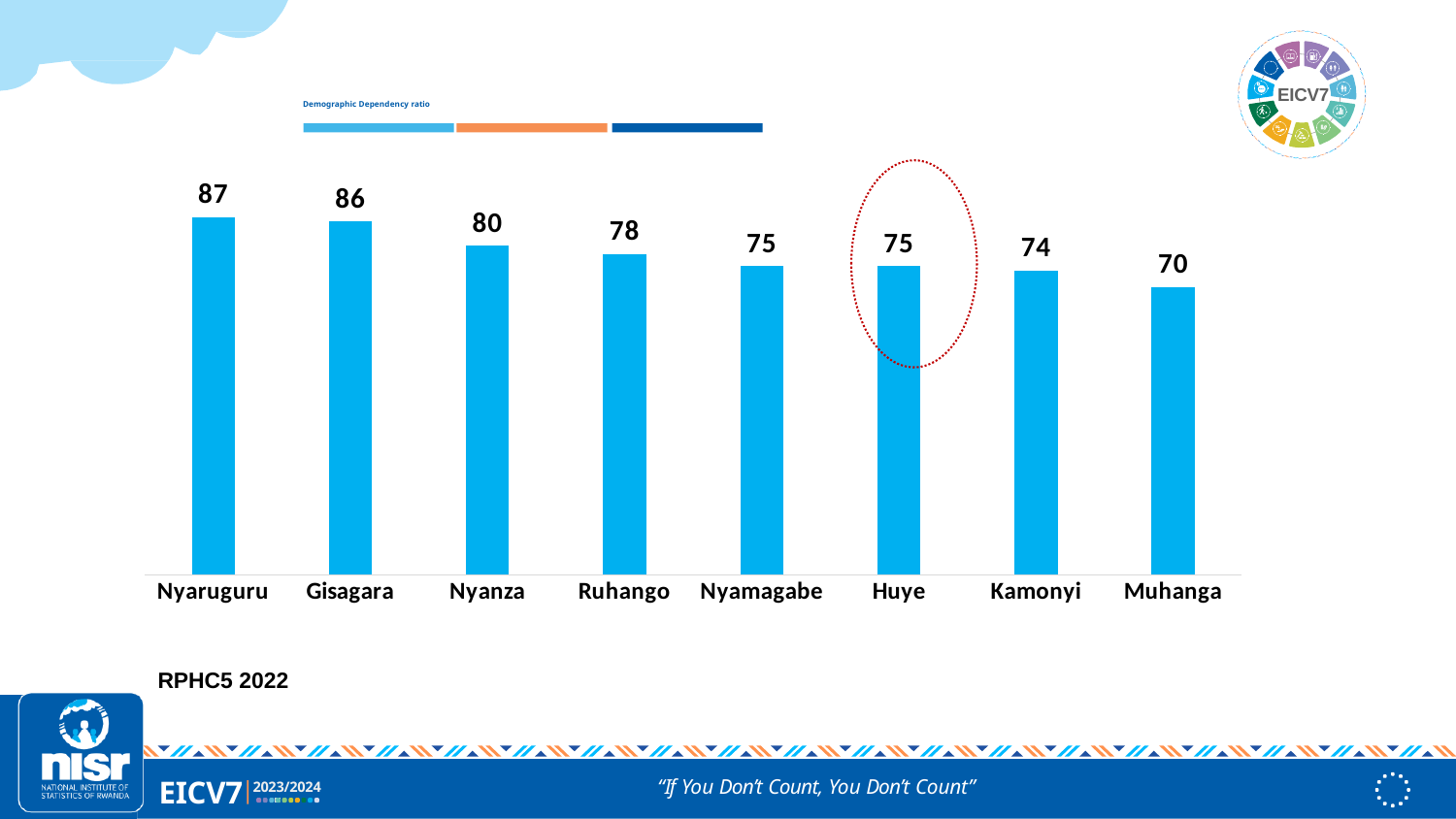
What is the value shown for Muhanga? 70 What is the value shown for Ruhango? 78 What is the difference between the values for Nyanza and Kamonyi? 6 What is the demographic dependency ratio for Nyaruguru? 87 Which district has the lowest value on the chart? Muhanga Which district has the highest value on the chart? Nyaruguru Which district's bar is highlighted with a dotted red circle? Huye What is the difference between the values for Nyaruguru and Muhanga? 17 Which has a larger value, Gisagara or Nyanza? Gisagara What is the value shown for Huye? 75 What kind of chart is shown on the slide? Bar chart How many districts are shown on the chart? 8